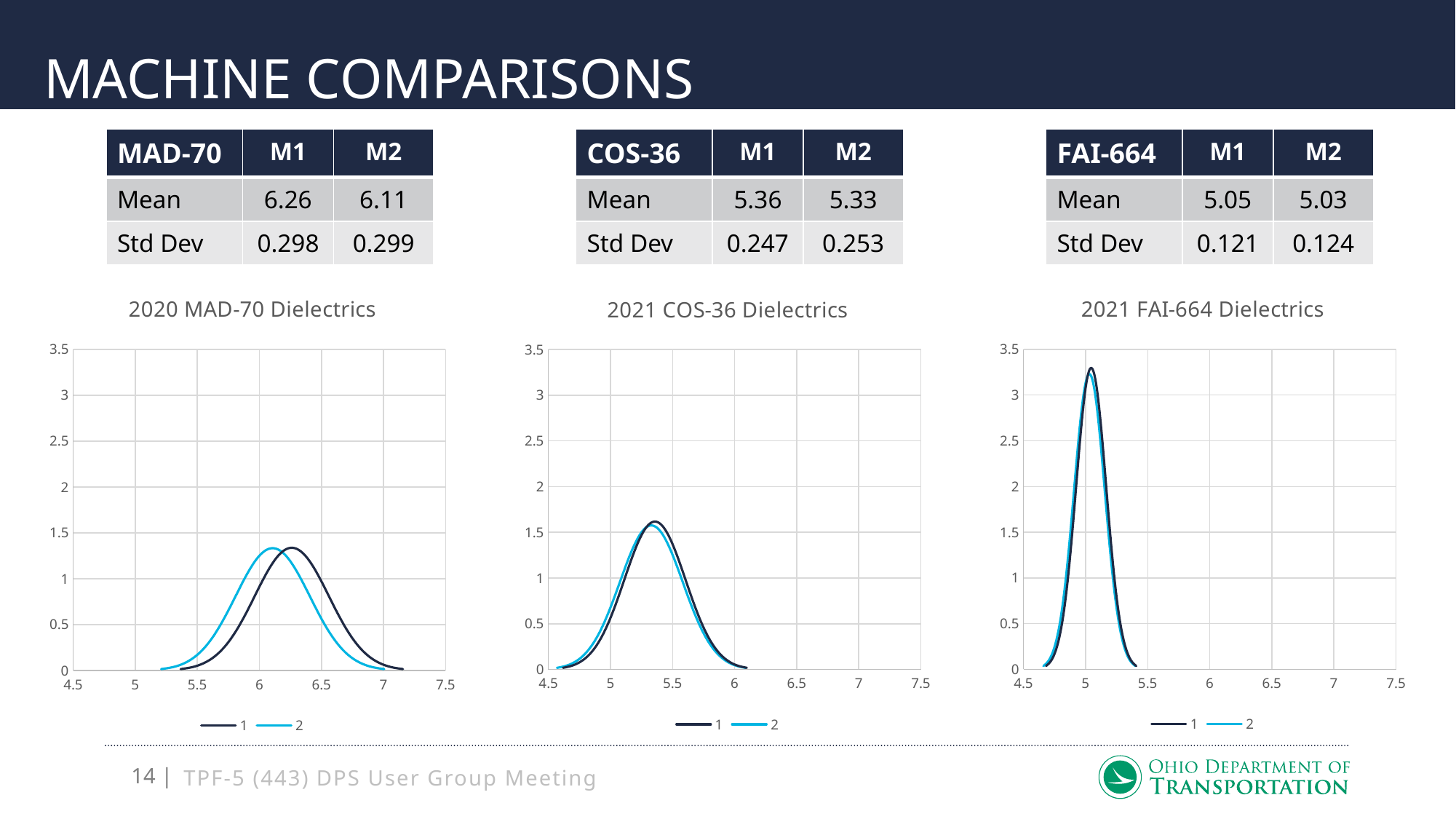
Is the peak of the "2021 FAI-664 Dielectrics" chart higher or lower than the peak of the "2021 COS-36 Dielectrics" chart? higher What is the title of the leftmost chart on the slide? 2020 MAD-70 Dielectrics In the "2021 FAI-664 Dielectrics" chart, is the peak value of series 1 greater or less than 3? greater Which of the three charts on the slide has the highest peak? 2021 FAI-664 Dielectrics Which of the three charts on the slide has the lowest peak? 2020 MAD-70 Dielectrics How many series does the legend of the "2021 COS-36 Dielectrics" chart list? 2 In the "2021 COS-36 Dielectrics" chart, is the peak value of series 1 greater or less than 1.5? greater In the "2020 MAD-70 Dielectrics" chart, which series peaks further to the right along the x axis, series 1 or series 2? series 1 In the "2020 MAD-70 Dielectrics" chart, is the peak value of series 2 greater or less than 1? greater What kind of chart is the "2020 MAD-70 Dielectrics" chart? line chart What are the legend entries of the "2021 FAI-664 Dielectrics" chart? 1 and 2